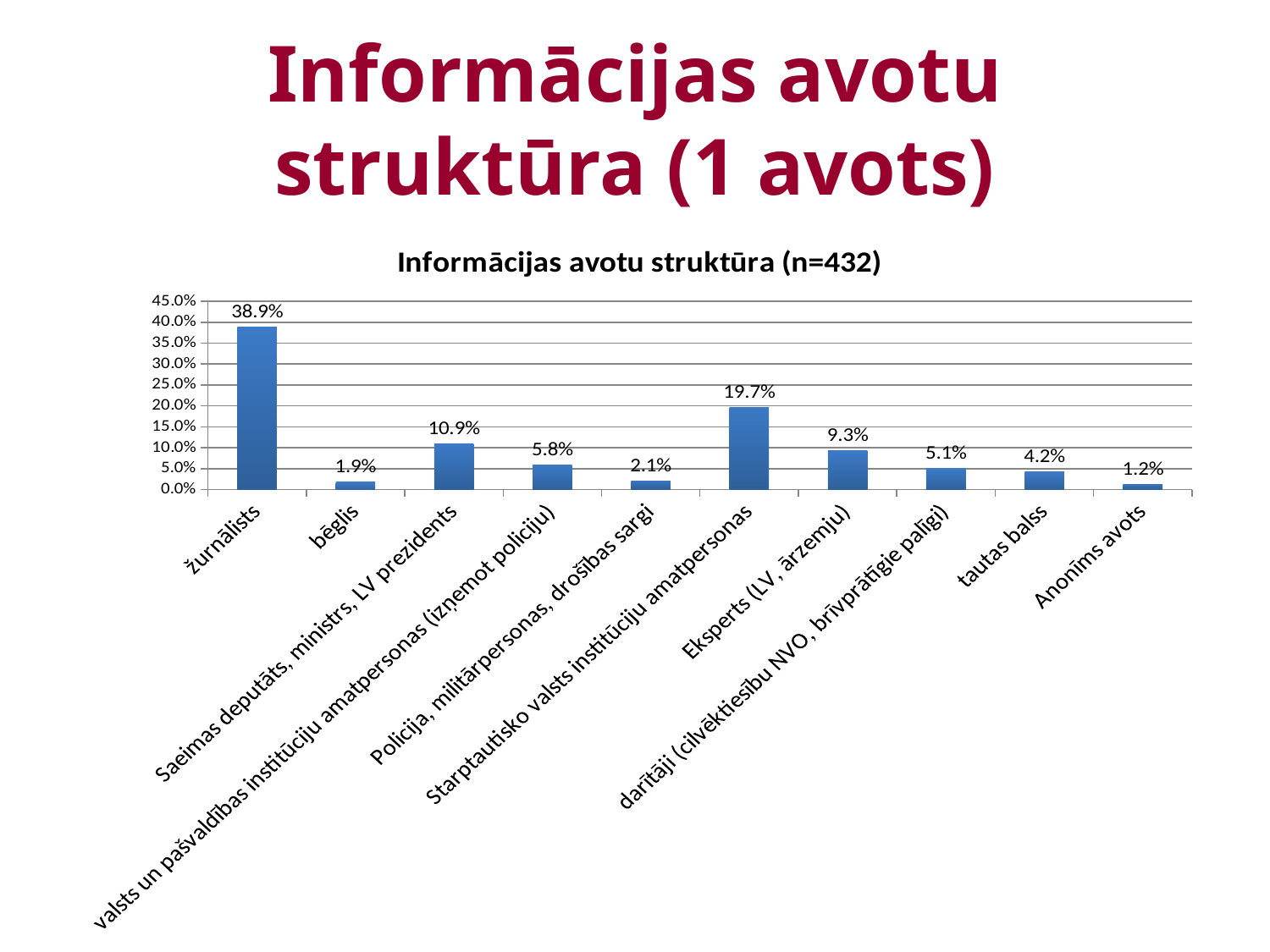
What kind of chart is shown on the slide? bar chart What is the value for Starptautisko valsts institūciju amatpersonas? 19.7% What is the value for tautas balss? 4.2% What is the title of the chart? Informācijas avotu struktūra (n=432) Which is larger, the value for bēglis or the value for Policija, militārpersonas, drošības sargi? Policija, militārpersonas, drošības sargi Which category has the highest value? žurnālists What is the value for žurnālists? 38.9% Which category has the lowest value? Anonīms avots What is the value for Eksperts (LV, ārzemju)? 9.3% What is the difference between the values for žurnālists and Starptautisko valsts institūciju amatpersonas? 19.2% Is the value for Saeimas deputāts, ministrs, LV prezidents greater or less than 10.0%? greater How many categories are shown on the chart? 10